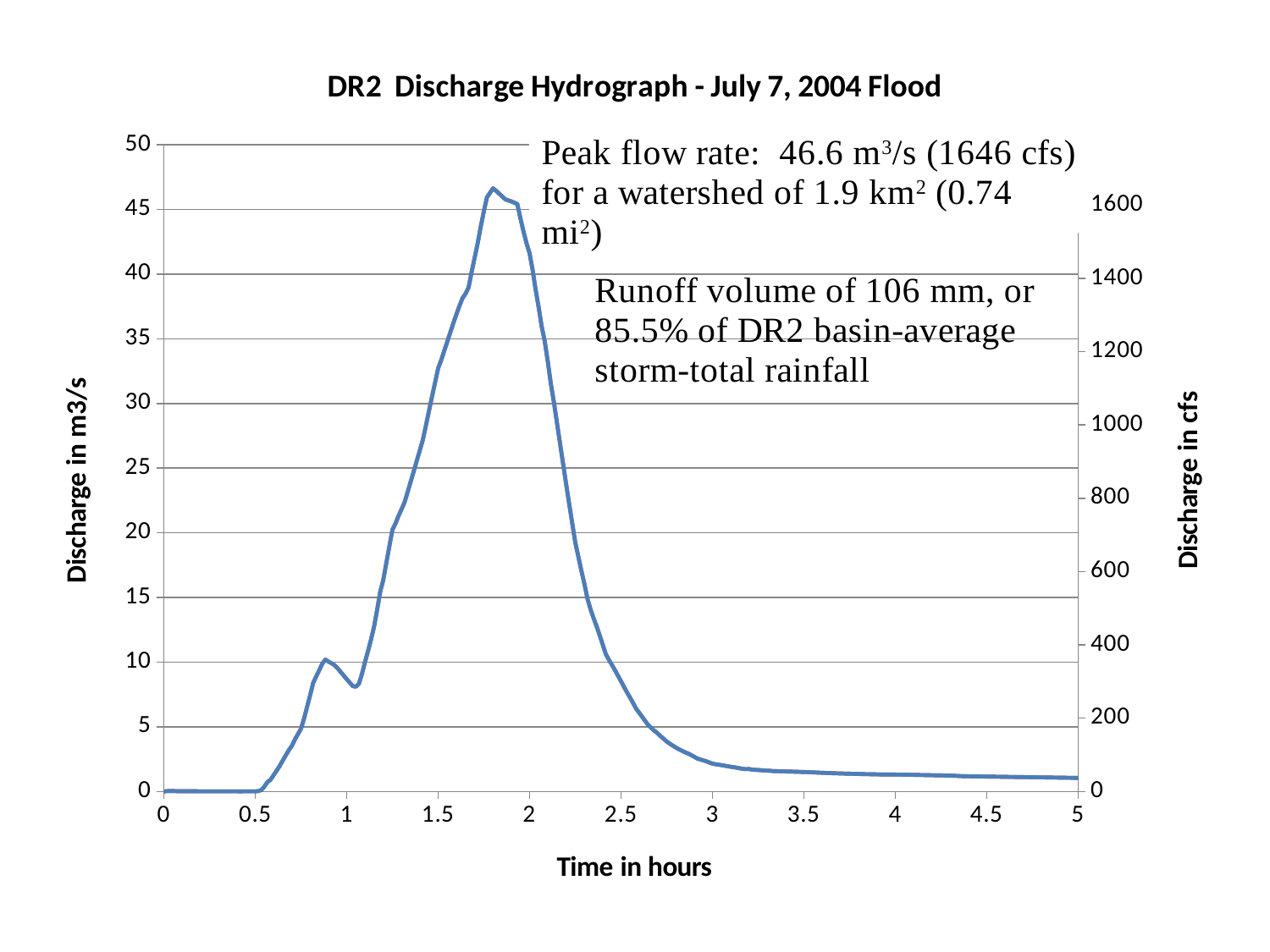
What kind of chart is shown on the slide? line chart What is the title of the chart? DR2 Discharge Hydrograph - July 7, 2004 Flood Does the discharge rise or fall between 2 and 3 hours? fall Which is larger, the discharge at 1.5 hours or at 2.5 hours? 1.5 hours What is the label of the x axis? Time in hours Is the discharge at 1 hour greater or less than 10 m3/s? less How many lines are plotted on the chart? 1 Is the discharge at 2 hours greater or less than 30 m3/s? greater What peak flow rate is stated on the slide? 46.6 m³/s (1646 cfs) Does the discharge rise or fall between 1 and 1.75 hours? rise Is the discharge at 2.5 hours greater or less than 15 m3/s? less